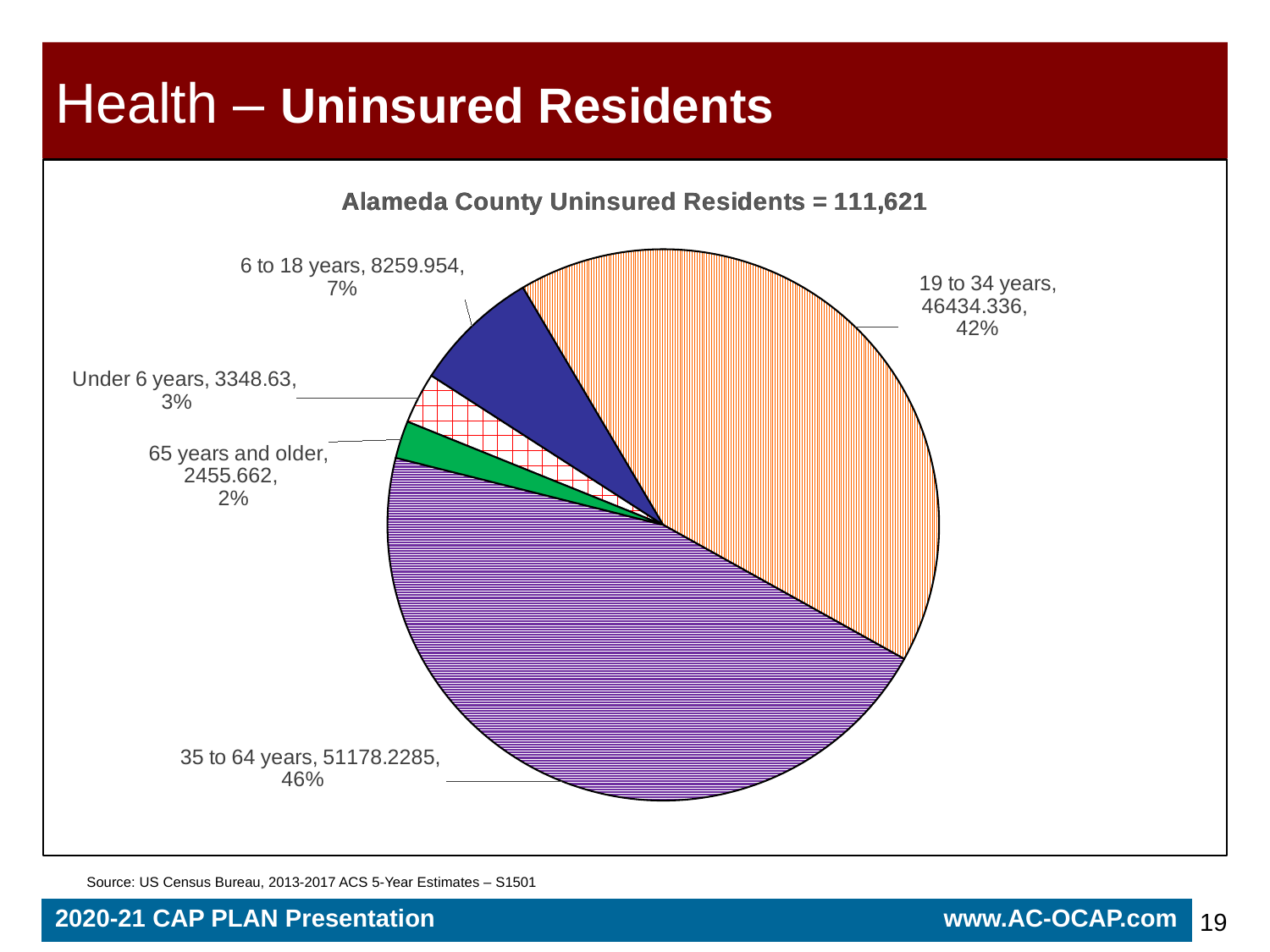
What is the title of the chart? Alameda County Uninsured Residents = 111,621 What value is shown for the 19 to 34 years slice? 46434.336 Which is larger, the share for Under 6 years or the share for 6 to 18 years? 6 to 18 years What percentage share of the pie does the 35 to 64 years slice represent? 46% Which age category has the smallest share of uninsured residents? 65 years and older What value is shown for the Under 6 years slice? 3348.63 What value is shown for the 65 years and older slice? 2455.662 What percentage share of the pie does the 6 to 18 years slice represent? 7% What value is shown for the 35 to 64 years slice? 51178.2285 How many age categories are shown in the pie chart? 5 Which age category has the largest share of uninsured residents? 35 to 64 years What type of chart is shown on the slide? Pie chart